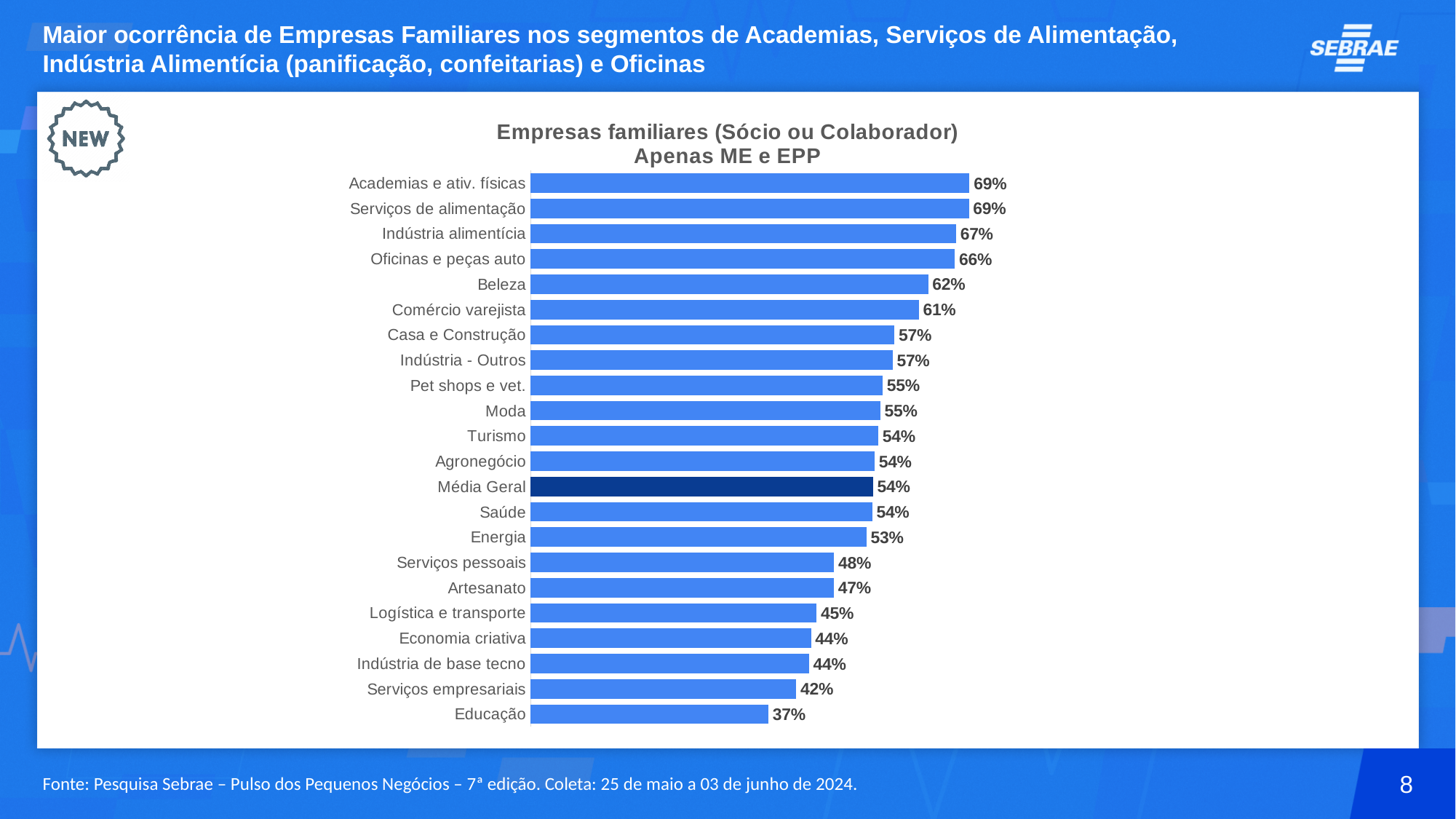
What is the value for Média Geral? 54% What is the difference between the values for Oficinas e peças auto and Comércio varejista? 5% Which bar is shown in a darker blue colour than the others? Média Geral How many categories are shown in the chart? 22 What is the value for Beleza? 62% Which is larger, the value for Artesanato or the value for Serviços empresariais? Artesanato What is the value for Logística e transporte? 45% Which is larger, the value for Indústria alimentícia or the value for Serviços pessoais? Indústria alimentícia What kind of chart is shown on the slide? Bar chart Which category has the lowest value? Educação What is the difference between the values for Academias e ativ. físicas and Educação? 32% What is the value for Educação? 37%